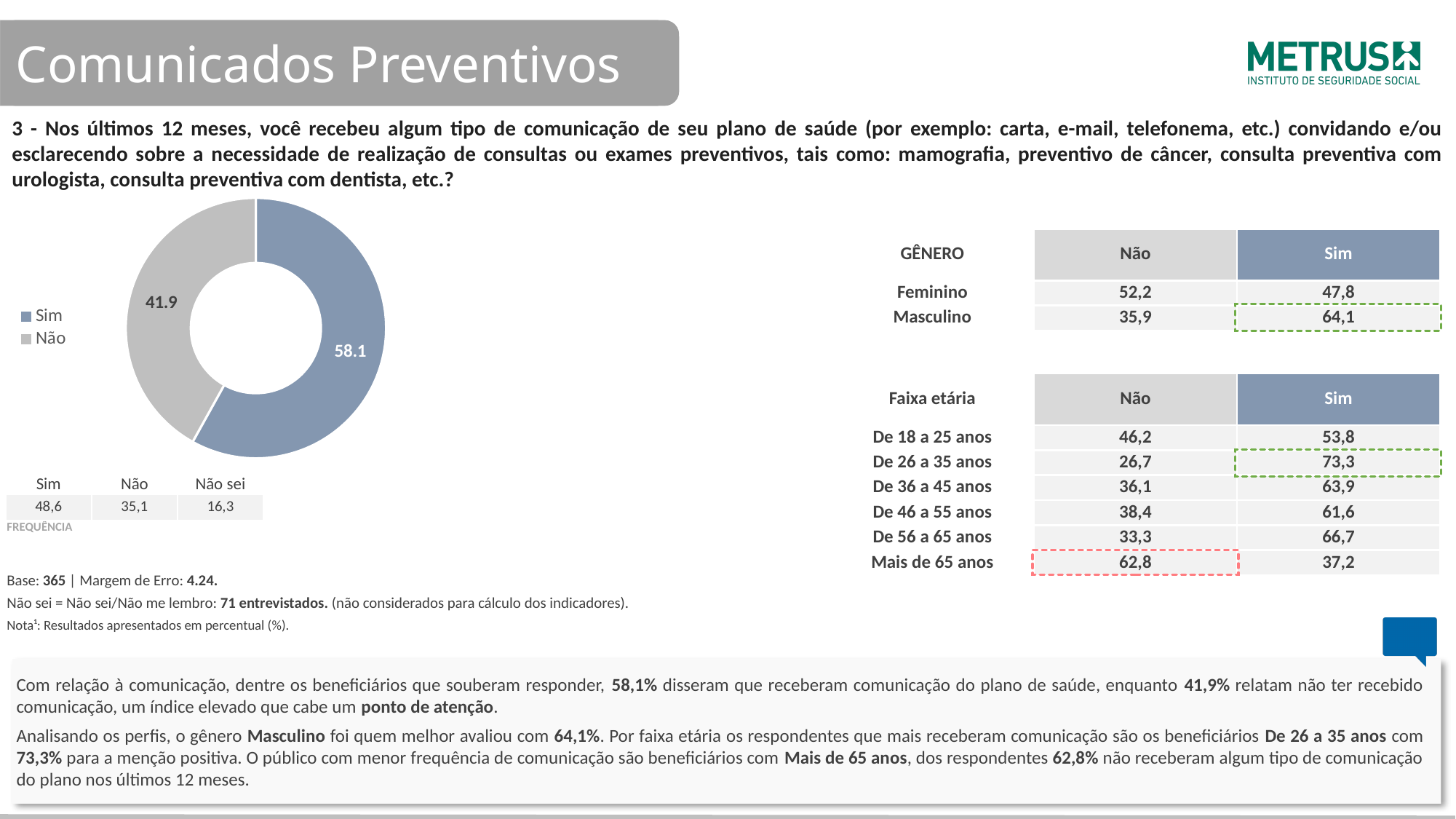
How many entries does the legend of the donut chart list? 2 In the donut chart, what is the value for "Sim"? 58.1 What colour is the "Não" slice in the donut chart? Grey What colour is the "Sim" slice in the donut chart? Blue How many slices does the donut chart have? 2 Which slice of the donut chart is the largest? Sim What is the difference between the "Sim" and "Não" values in the donut chart? 16.2 In the donut chart, what is the value for "Não"? 41.9 In the donut chart, which is larger: "Sim" or "Não"? Sim What kind of chart is shown on the left of the slide? Pie chart (donut) Which slice of the donut chart is the smallest? Não